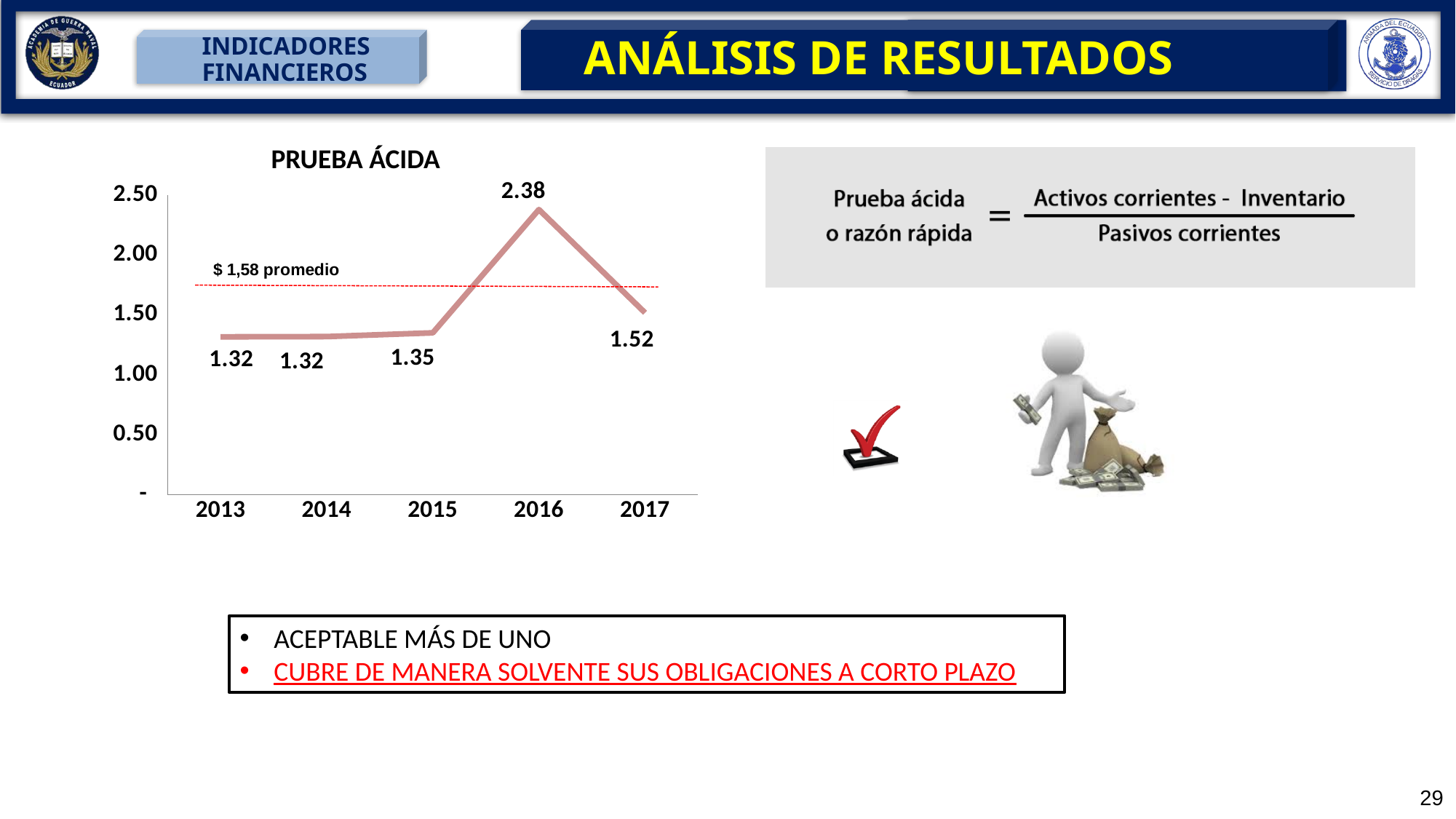
What average value is labelled on the dashed line in the PRUEBA ÁCIDA chart? $ 1,58 promedio How many years are plotted in the PRUEBA ÁCIDA chart? 5 Is the PRUEBA ÁCIDA value for 2016 greater or less than 2.00? greater Which is larger, the PRUEBA ÁCIDA value for 2017 or for 2015? 2017 What is the value of the PRUEBA ÁCIDA for 2015? 1.35 What is the value of the PRUEBA ÁCIDA for 2016? 2.38 What is the difference between the PRUEBA ÁCIDA values for 2016 and 2017? 0.86 What kind of chart is the PRUEBA ÁCIDA chart? line chart Which year has the highest PRUEBA ÁCIDA value? 2016 What is the difference between the PRUEBA ÁCIDA values for 2015 and 2013? 0.03 Does the PRUEBA ÁCIDA value rise or fall from 2016 to 2017? fall What is the value of the PRUEBA ÁCIDA for 2017? 1.52